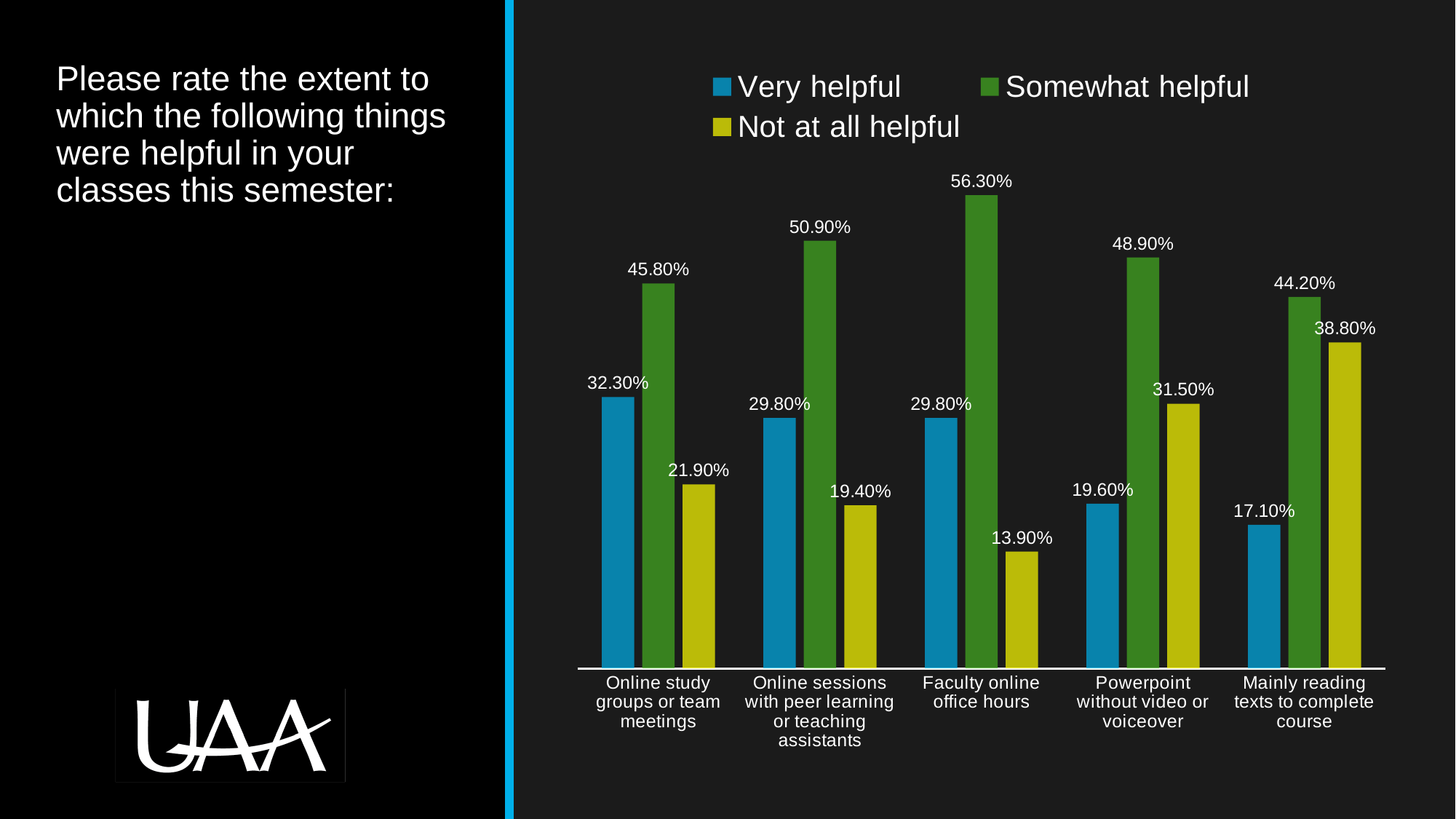
What is the Very helpful value for Online study groups or team meetings? 32.30% Which category has the lowest Not at all helpful value? Faculty online office hours How many categories are shown on the x axis? 5 What is the difference between the Somewhat helpful and Very helpful values for Powerpoint without video or voiceover? 29.30% How many series does the legend list? 3 Which category has the lowest Very helpful value? Mainly reading texts to complete course What percentage rated Faculty online office hours as Somewhat helpful? 56.30% Which is larger for Online sessions with peer learning or teaching assistants: the Very helpful value or the Not at all helpful value? Very helpful Which category has the highest Somewhat helpful value? Faculty online office hours What kind of chart is shown on the slide? Bar chart Which colour represents the Not at all helpful series? Yellow What percentage rated Mainly reading texts to complete course as Not at all helpful? 38.80%